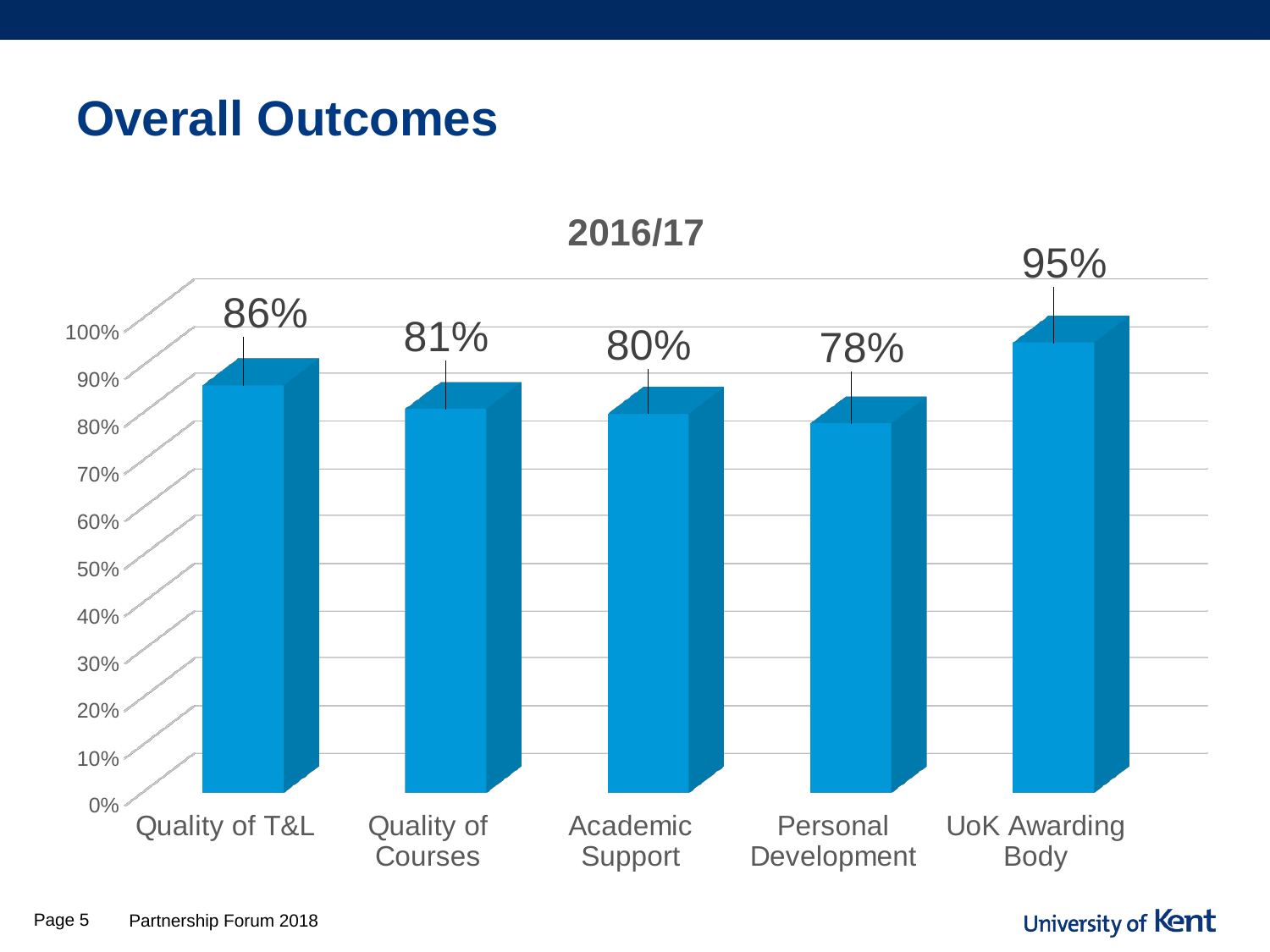
What is the title of the chart? 2016/17 Which category has the highest value? UoK Awarding Body What is the value for Academic Support? 80% What is the difference between the values for UoK Awarding Body and Personal Development? 17% What is the value for Quality of T&L? 86% What is the value for Personal Development? 78% What is the value for UoK Awarding Body? 95% What kind of chart is shown on the slide? Bar chart Which category has the lowest value? Personal Development What is the value for Quality of Courses? 81% Which is larger, the value for Quality of T&L or the value for Quality of Courses? Quality of T&L How many categories are shown on the chart? 5